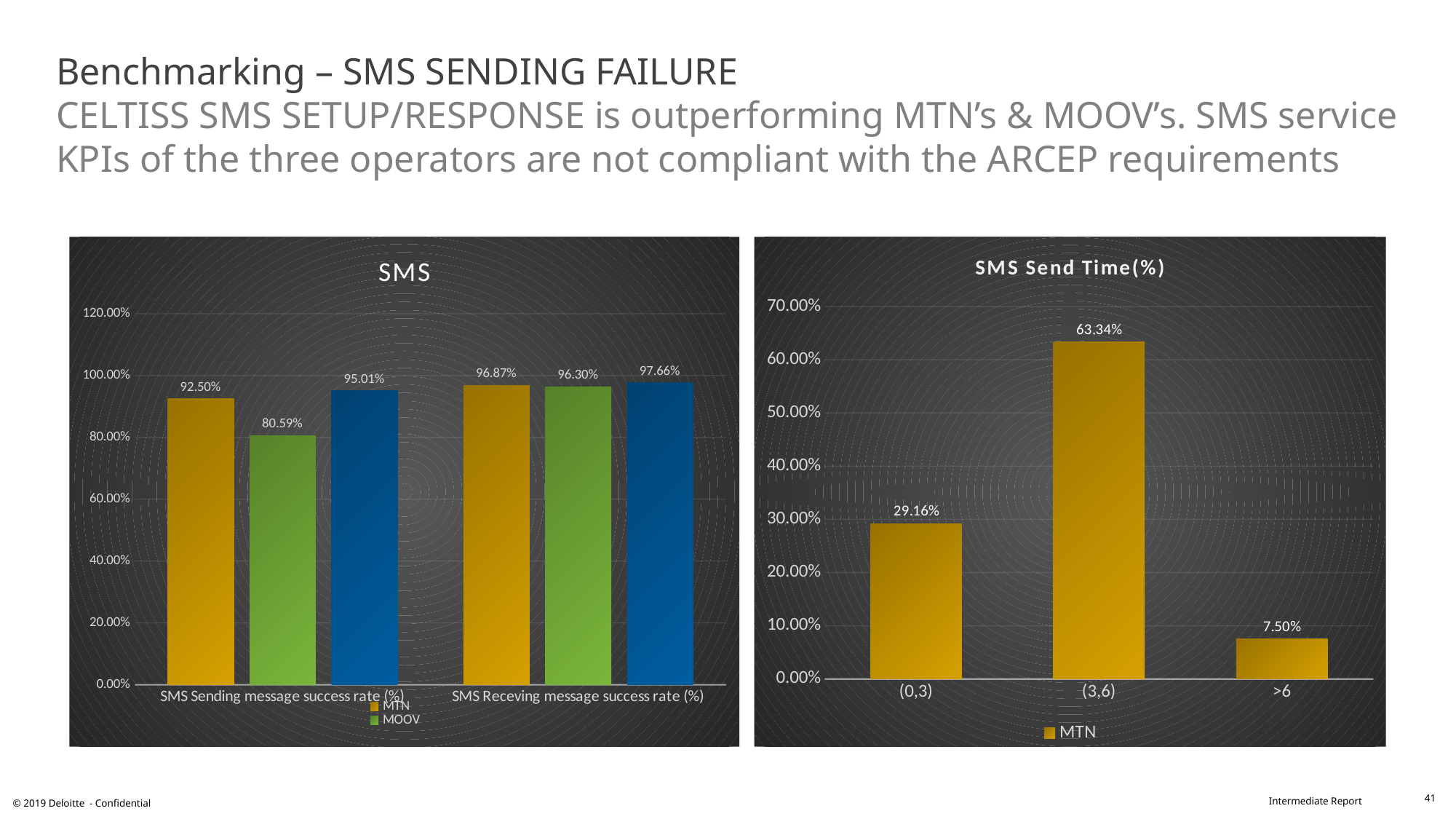
What kind of chart is the SMS Send Time(%) chart? bar chart In the SMS chart on the left, what is the MOOV value for SMS Sending message success rate (%)? 80.59% In the SMS Send Time(%) chart, what is the difference between the (3,6) value and the (0,3) value? 34.18% In the SMS chart on the left, what is the difference between the MTN and MOOV values for SMS Sending message success rate (%)? 11.91% In the SMS Send Time(%) chart, which category has the highest value? (3,6) In the SMS chart on the left, what is the MTN value for SMS Receiving message success rate (%)? 96.87% What is the title of the chart on the right of the slide? SMS Send Time(%) In the SMS Send Time(%) chart, what is the value for the (3,6) category? 63.34% How many categories are shown on the x axis of the SMS chart on the left? 2 How many categories are shown on the x axis of the SMS Send Time(%) chart? 3 In the SMS Send Time(%) chart, which category has the lowest value? >6 In the SMS chart on the left, which is larger for SMS Receiving message success rate (%): MTN or MOOV? MTN